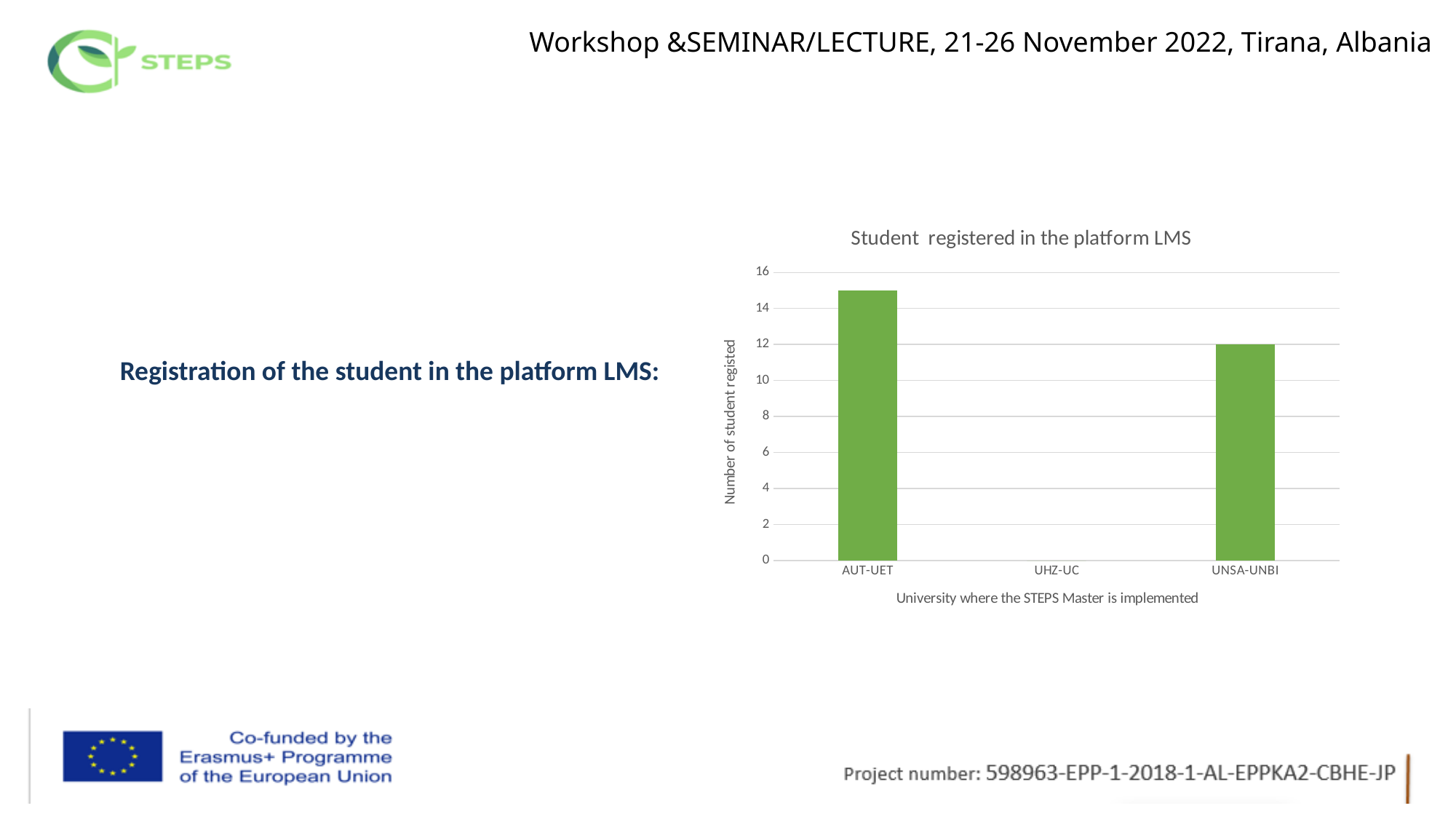
Is the value for AUT-UET greater or less than 14? greater Which university has the lowest number of students registered in the platform LMS? UHZ-UC What is the label of the x axis of the chart? University where the STEPS Master is implemented Is the value for AUT-UET greater or less than 16? less What is the title of the chart? Student registered in the platform LMS How many universities are shown on the x axis of the chart? 3 Is the value for UNSA-UNBI greater or less than 10? greater Which university has the highest number of students registered in the platform LMS? AUT-UET Which has more students registered in the platform LMS, AUT-UET or UNSA-UNBI? AUT-UET How many students are registered in the platform LMS for UNSA-UNBI? 12 What kind of chart is shown on the slide? Bar chart